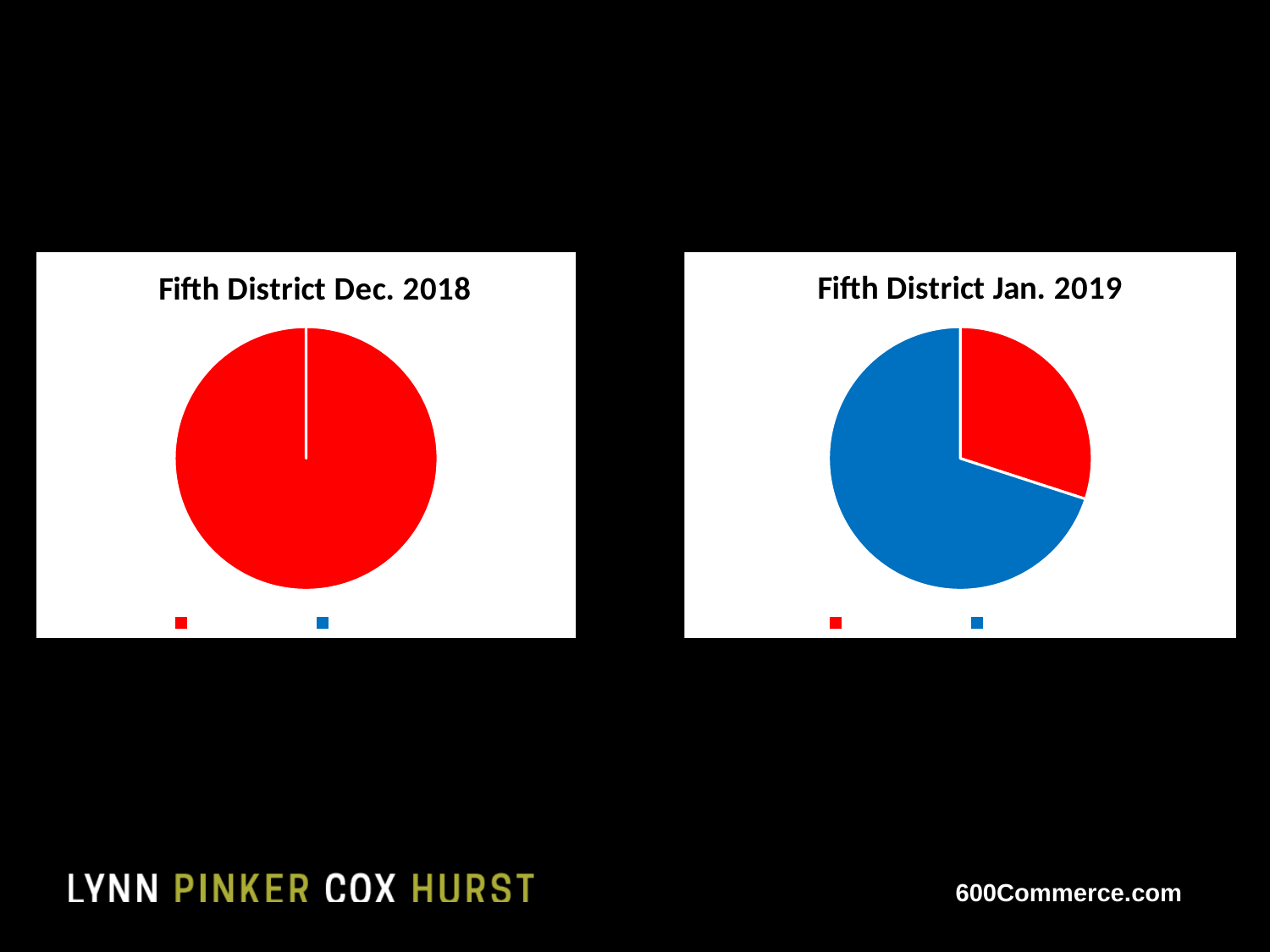
What kind of chart is the right chart titled "Fifth District Jan. 2019"? pie chart In the "Fifth District Dec. 2018" chart, which colour slice makes up essentially the whole pie? red In the "Fifth District Jan. 2019" chart, which colour slice is larger, the red one or the blue one? blue What is the title of the chart on the left of the slide? Fifth District Dec. 2018 In the "Fifth District Jan. 2019" chart, how many visible slices does the pie have? 2 What is the title of the chart on the right of the slide? Fifth District Jan. 2019 In the "Fifth District Jan. 2019" chart, is the red slice larger or smaller than the blue slice? smaller In the "Fifth District Dec. 2018" chart, how many entries does the legend show? 2 What kind of chart is the left chart titled "Fifth District Dec. 2018"? pie chart Comparing the two charts, which colour slice grew from Dec. 2018 to Jan. 2019? blue In the "Fifth District Jan. 2019" chart, is the blue slice more or less than half of the pie? more In the "Fifth District Jan. 2019" chart, how many entries does the legend show? 2